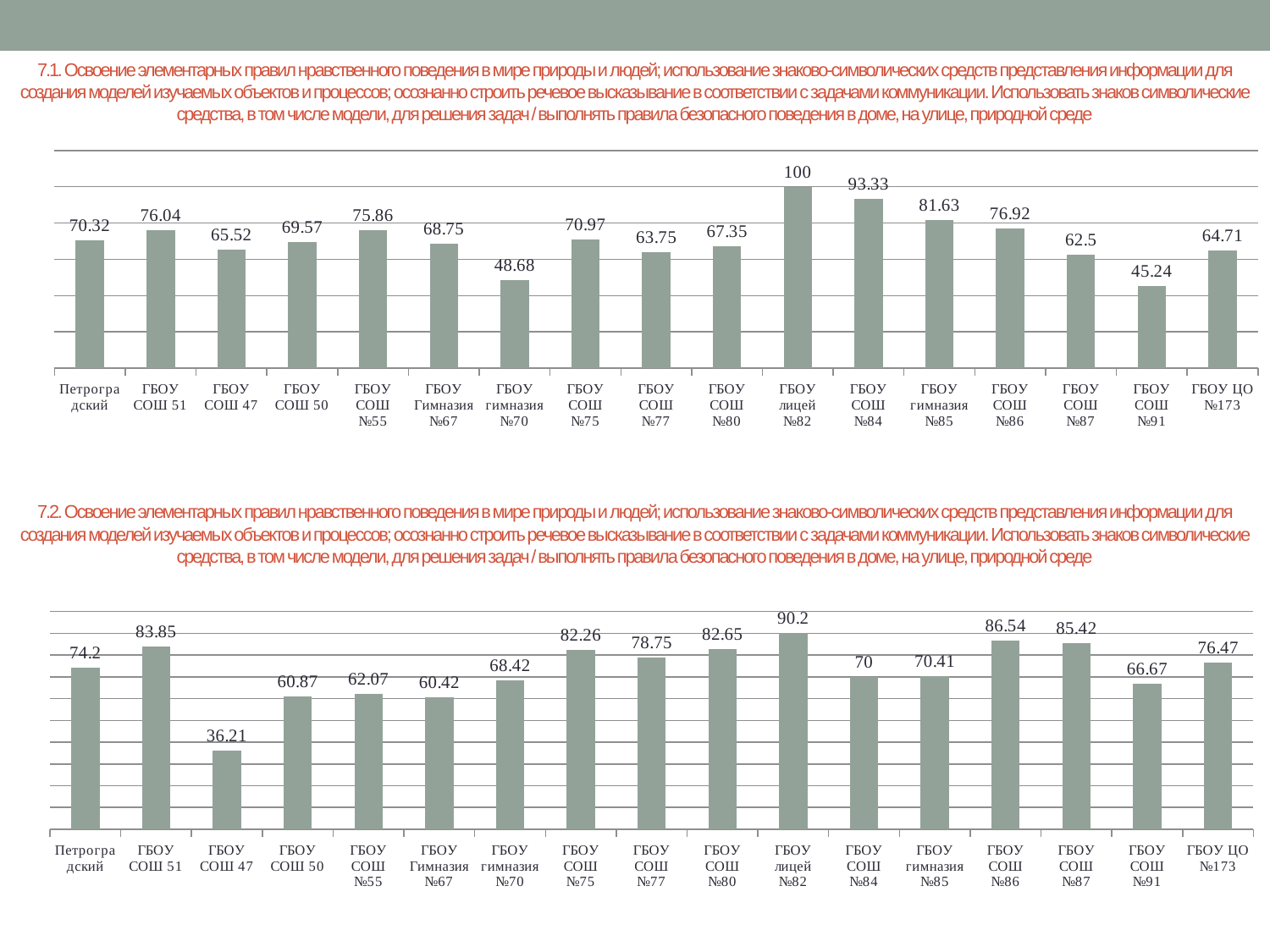
In the bottom chart, which is larger, the value for Петроградский or the value for ГБОУ ЦО №173? ГБОУ ЦО №173 In the bottom chart, which category has the highest value? ГБОУ лицей №82 In the top chart, which is larger, the value for ГБОУ СОШ 51 or the value for ГБОУ СОШ №86? ГБОУ СОШ №86 In the top chart, what is the value for ГБОУ лицей №82? 100 In the bottom chart, what is the difference between the values for ГБОУ СОШ №86 and ГБОУ СОШ №87? 1.12 In the bottom chart, what is the value for ГБОУ СОШ №84? 70 In the bottom chart, what is the value for ГБОУ СОШ 47? 36.21 What type of chart is the bottom chart? Bar chart In the top chart, what is the value for ГБОУ гимназия №70? 48.68 In the top chart, which category has the lowest value? ГБОУ СОШ №91 How many categories are shown in the top chart? 17 In the top chart, what is the difference between the values for ГБОУ СОШ №84 and ГБОУ гимназия №85? 11.7